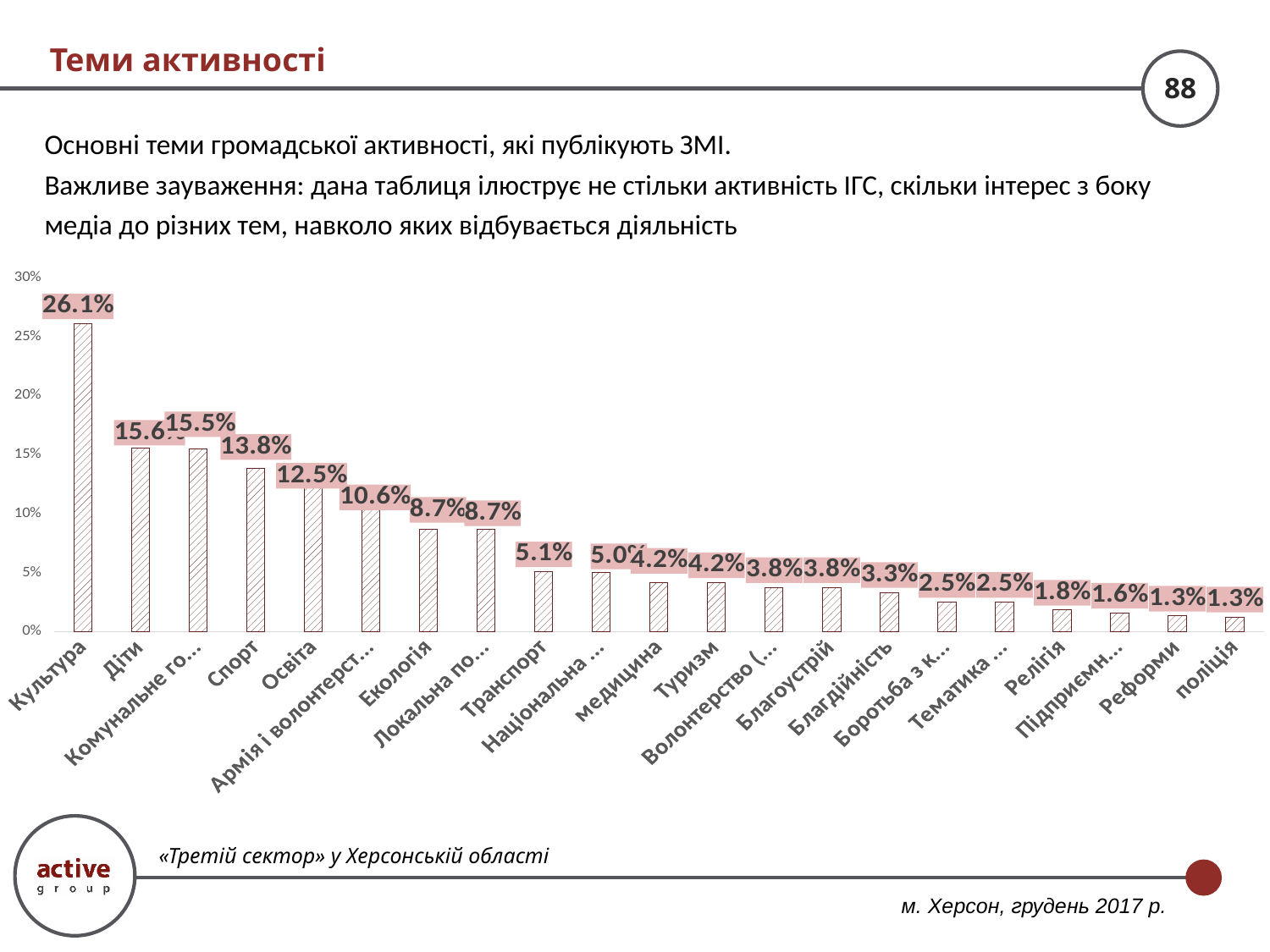
What is the value for Культура? 26.1% Do the values rise or fall from left to right along the x axis? fall What is the difference between the values for Культура and Діти? 10.5% Is the value for Діти greater or less than 15%? greater What is the value for Спорт? 13.8% How many categories are shown on the chart? 21 What is the value for Транспорт? 5.1% Which is larger, the value for Екологія or the value for Туризм? Екологія What is the value for Релігія? 1.8% Which category has the highest value? Культура What kind of chart is shown on the slide? bar chart What is the value for Освіта? 12.5%